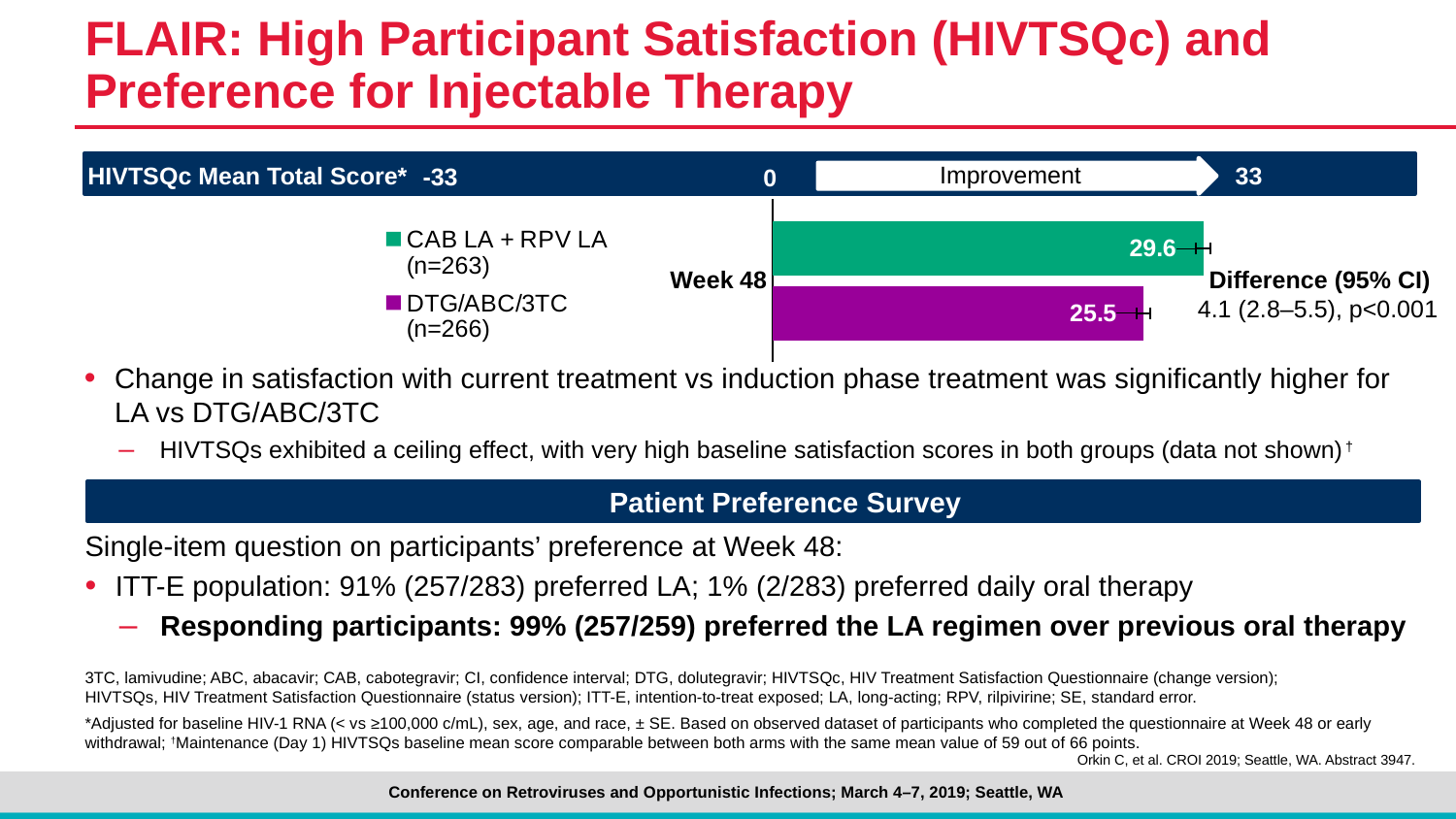
What time point is shown on the HIVTSQc mean total score chart? Week 48 What is the maximum value shown on the HIVTSQc mean total score axis? 33 Is the HIVTSQc mean total score for CAB LA + RPV LA larger or smaller than that for DTG/ABC/3TC? larger What kind of chart is used to show the HIVTSQc mean total scores? Bar chart What is the sample size (n) for the DTG/ABC/3TC group in the chart legend? 266 What is the difference between the HIVTSQc mean total scores of CAB LA + RPV LA and DTG/ABC/3TC at Week 48? 4.1 What is the HIVTSQc mean total score at Week 48 for CAB LA + RPV LA? 29.6 Which treatment group has the lower HIVTSQc mean total score at Week 48? DTG/ABC/3TC How many series does the legend of the HIVTSQc chart list? 2 What is the HIVTSQc mean total score at Week 48 for DTG/ABC/3TC? 25.5 Is the HIVTSQc mean total score for DTG/ABC/3TC greater or less than 0? greater Which treatment group has the higher HIVTSQc mean total score at Week 48? CAB LA + RPV LA